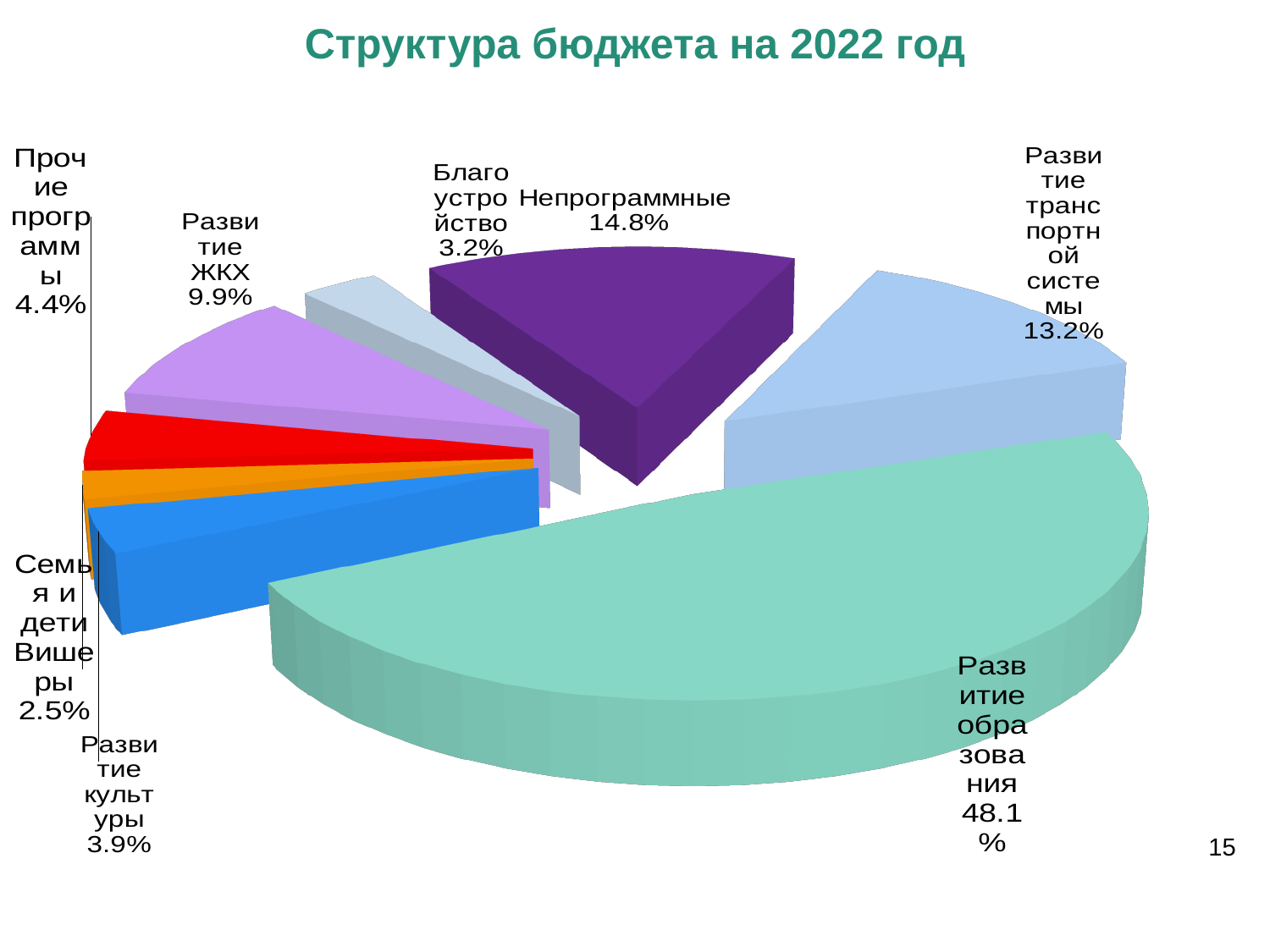
Which category has the largest share of the budget? Развитие образования What share of the budget goes to Развитие образования? 48.1% What share of the budget goes to Семья и дети Вишеры? 2.5% Which is larger, the share for Развитие культуры or the share for Благоустройство? Развитие культуры What share of the budget is labelled Непрограммные? 14.8% What share of the budget goes to Развитие транспортной системы? 13.2% What is the difference in percentage points between Непрограммные and Развитие транспортной системы? 1.6 How many slices does the pie chart have? 8 What share of the budget goes to Развитие ЖКХ? 9.9% Which category has the smallest share of the budget? Семья и дети Вишеры What is the title of the chart? Структура бюджета на 2022 год What kind of chart is shown on the slide? pie chart